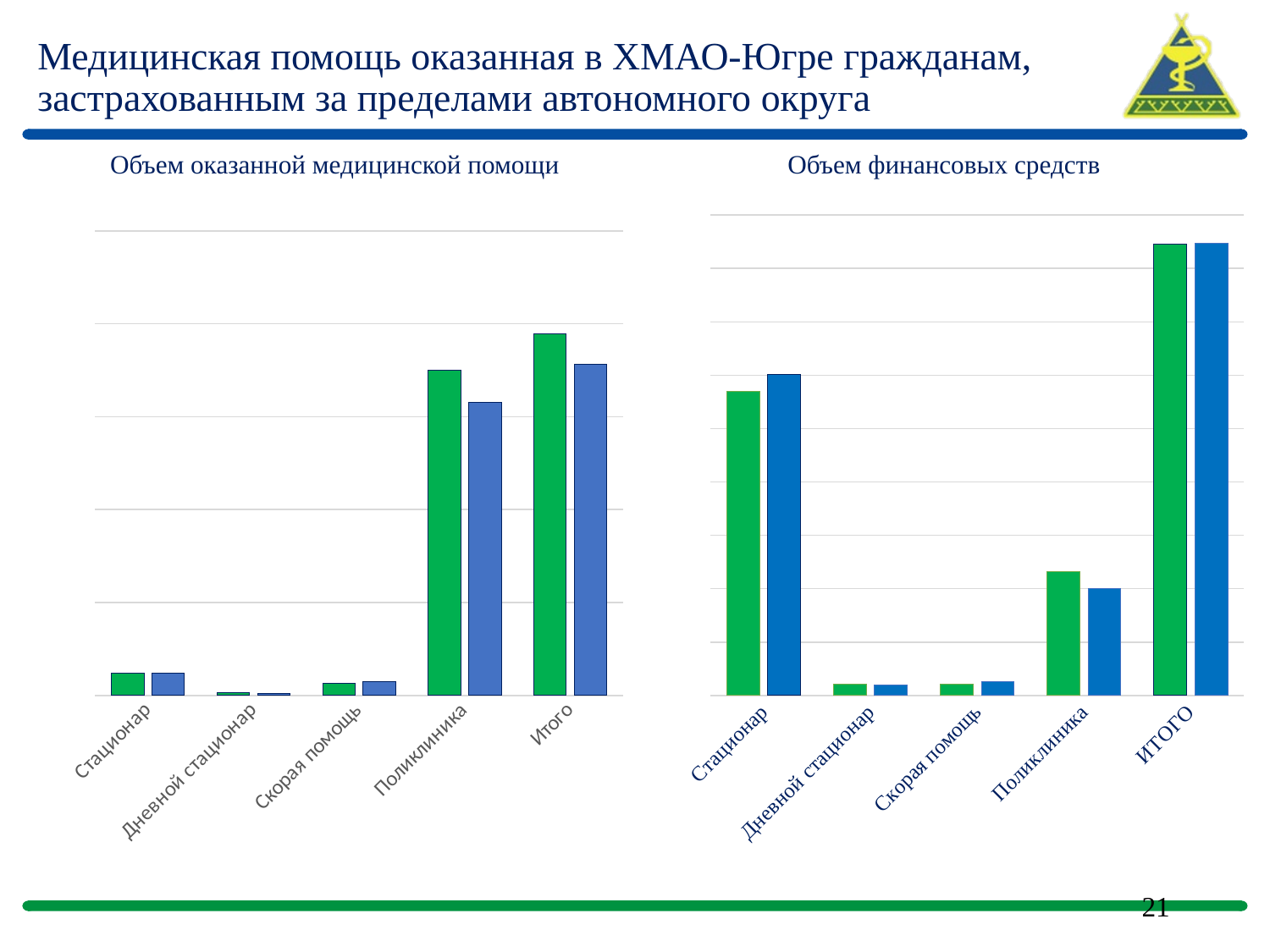
In the left chart "Объем оказанной медицинской помощи", for Поликлиника, is the green bar or the blue bar taller? green What kind of chart is the left chart titled "Объем оказанной медицинской помощи"? bar chart In the right chart "Объем финансовых средств", which category has the tallest bars? ИТОГО How many categories are shown on the x axis of the left chart "Объем оказанной медицинской помощи"? 5 In the left chart "Объем оказанной медицинской помощи", which category has the tallest bar? Итого How many bars are shown for each category in the right chart "Объем финансовых средств"? 2 What is the title of the chart on the right side of the slide? Объем финансовых средств How many categories are shown on the x axis of the right chart "Объем финансовых средств"? 5 In the right chart "Объем финансовых средств", for Стационар, is the green bar or the blue bar taller? blue In the right chart "Объем финансовых средств", which is larger, the green bar for Стационар or the green bar for Поликлиника? Стационар What kind of chart is the right chart titled "Объем финансовых средств"? bar chart In the left chart "Объем оказанной медицинской помощи", which category has the lowest bars? Дневной стационар